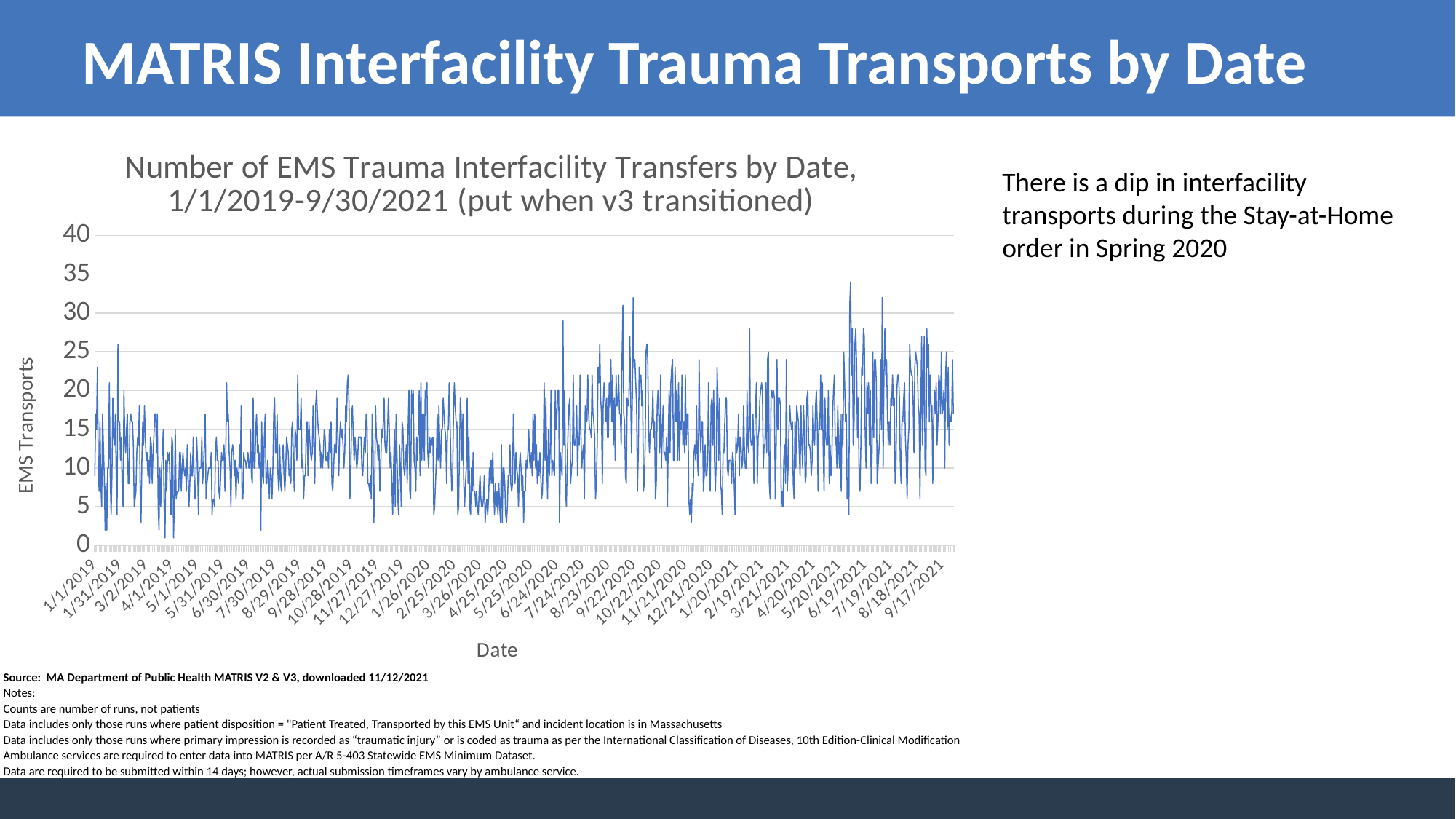
What kind of chart is shown on the slide? line chart Is the highest daily value plotted on the chart greater or less than 30? greater What is the title of the chart? Number of EMS Trauma Interfacility Transfers by Date, 1/1/2019-9/30/2021 (put when v3 transitioned) Is the lowest daily value plotted on the chart greater or less than 5? less Overall, do the daily transport counts rise or fall from 2019 to 2021? rise Is the value plotted for 1/1/2019 greater or less than 20? less What is the label on the vertical axis of the chart? EMS Transports Which period shows higher daily transport counts: around 4/25/2020 or around 8/23/2020? around 8/23/2020